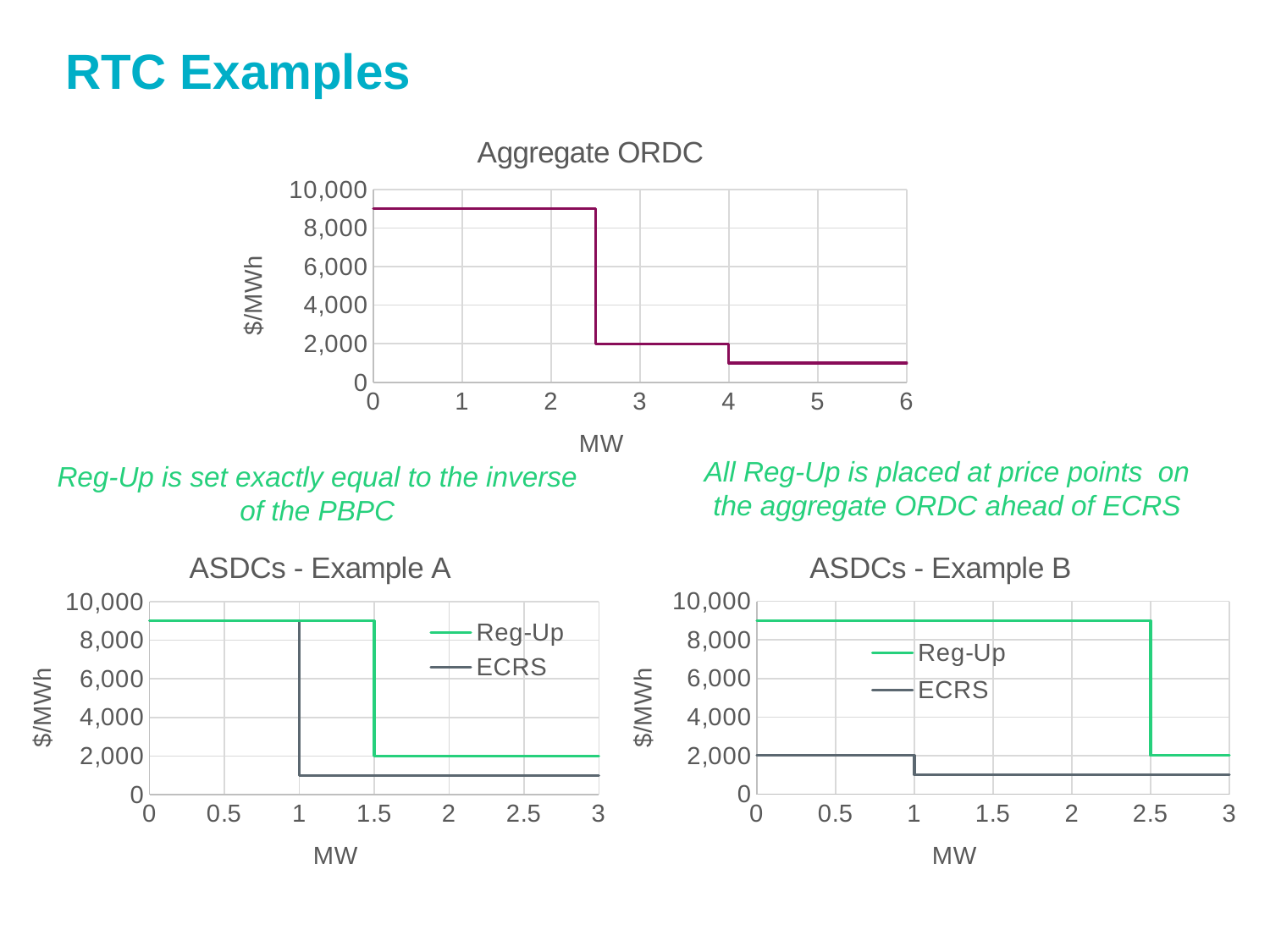
On the Aggregate ORDC chart, is the value at 5 MW greater or less than 2,000? less What kind of chart is the Aggregate ORDC chart? line chart On the Aggregate ORDC chart, do the values rise or fall as MW increases? fall On the ASDCs - Example B chart, at what MW does the Reg-Up line drop? 2.5 How many series does the legend of the ASDCs - Example A chart list? 2 On the ASDCs - Example A chart, which series has the larger value at 2 MW, Reg-Up or ECRS? Reg-Up On the ASDCs - Example B chart, what is the ECRS value at 0.5 MW? 2,000 On the Aggregate ORDC chart, at what MW does the line drop to its lowest level? 4 On the Aggregate ORDC chart, is the value at 1 MW greater or less than 8,000? greater What are the legend entries on the ASDCs - Example B chart? Reg-Up, ECRS What is the y-axis label on the ASDCs - Example A chart? $/MWh On the ASDCs - Example A chart, at what MW does the ECRS line drop? 1